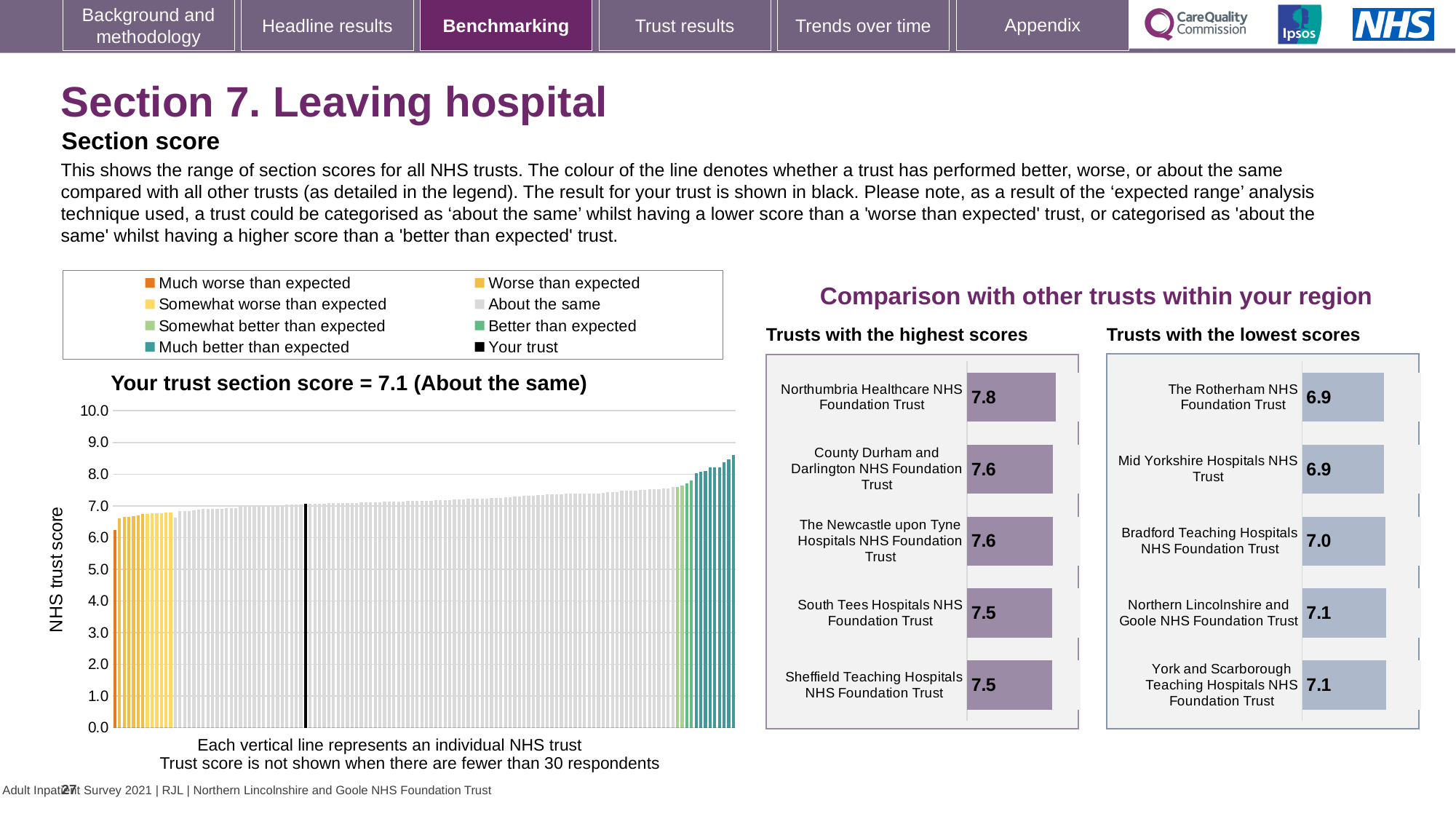
In the main chart on the left, what is the section score for your trust? 7.1 What kind of chart is the main chart on the left showing all NHS trusts? Bar chart In the main chart on the left, do the trust scores rise or fall from left to right along the x axis? Rise How many entries does the legend above the main chart on the left list? 8 In the main chart on the left, is the value of the tallest bar greater or less than 8.0? greater In the 'Trusts with the highest scores' chart, what is the score for Northumbria Healthcare NHS Foundation Trust? 7.8 In the 'Trusts with the lowest scores' chart, how many trusts are shown? 5 In the 'Trusts with the highest scores' chart, what is the difference between the scores of Northumbria Healthcare NHS Foundation Trust and South Tees Hospitals NHS Foundation Trust? 0.3 In the 'Trusts with the lowest scores' chart, which has the larger score: Bradford Teaching Hospitals NHS Foundation Trust or The Rotherham NHS Foundation Trust? Bradford Teaching Hospitals NHS Foundation Trust In the 'Trusts with the highest scores' chart, how many trusts are shown? 5 In the 'Trusts with the lowest scores' chart, what is the score for Bradford Teaching Hospitals NHS Foundation Trust? 7.0 In the 'Trusts with the highest scores' chart, which trust has the highest score? Northumbria Healthcare NHS Foundation Trust